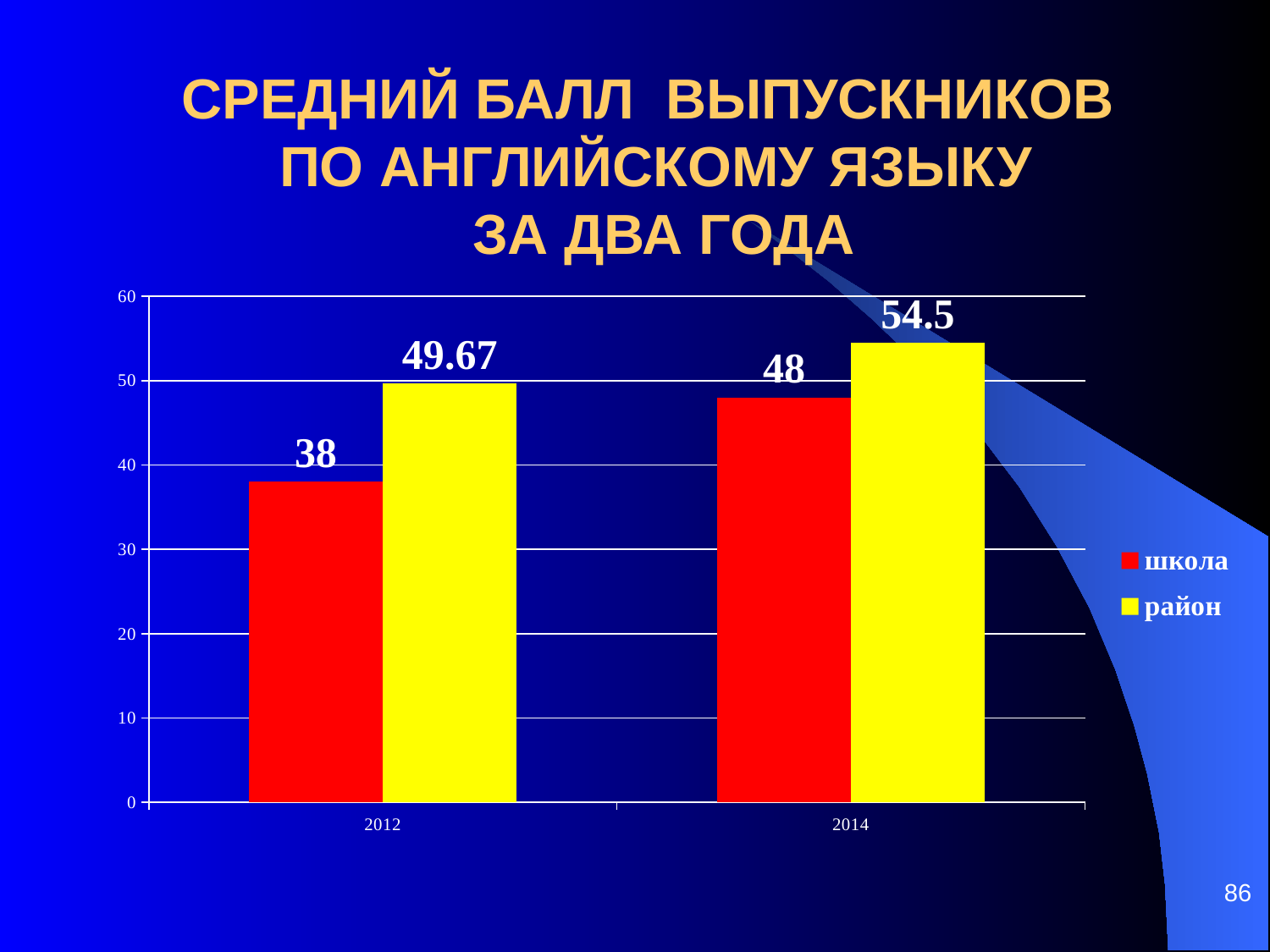
What is the value for школа in 2014? 48 What is the value for район in 2014? 54.5 Which year has the highest value for школа? 2014 What kind of chart is shown on the slide? bar chart How many categories are shown on the x axis? 2 What is the value for школа in 2012? 38 Which year has the lowest value for район? 2012 What is the value for район in 2012? 49.67 Which is larger in 2012: школа or район? район Do the район values rise or fall from 2012 to 2014? rise What is the difference between the школа values for 2014 and 2012? 10 How many series does the legend list? 2